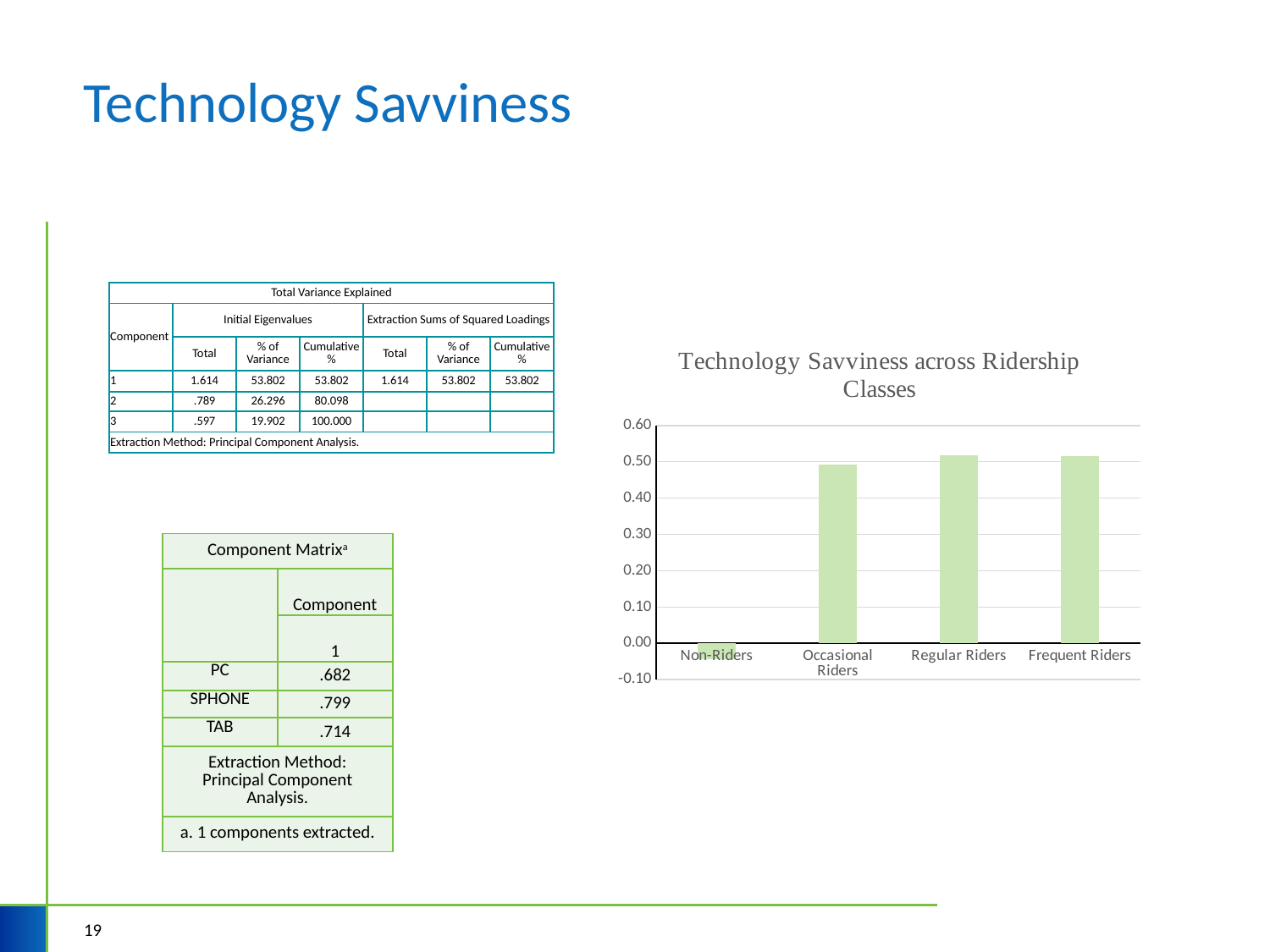
Which ridership class has the lowest value in the chart? Non-Riders What kind of chart is shown on the slide? bar chart What is the lowest value shown on the vertical axis of the chart? -0.10 Which has the larger value, Non-Riders or Occasional Riders? Occasional Riders Which has the larger value, Non-Riders or Frequent Riders? Frequent Riders What is the title of the chart? Technology Savviness across Ridership Classes Is the value for Regular Riders greater or less than 0.60? less Is the value for Non-Riders greater or less than 0.00? less Is the value for Occasional Riders greater or less than 0.40? greater How many ridership classes are plotted in the chart? 4